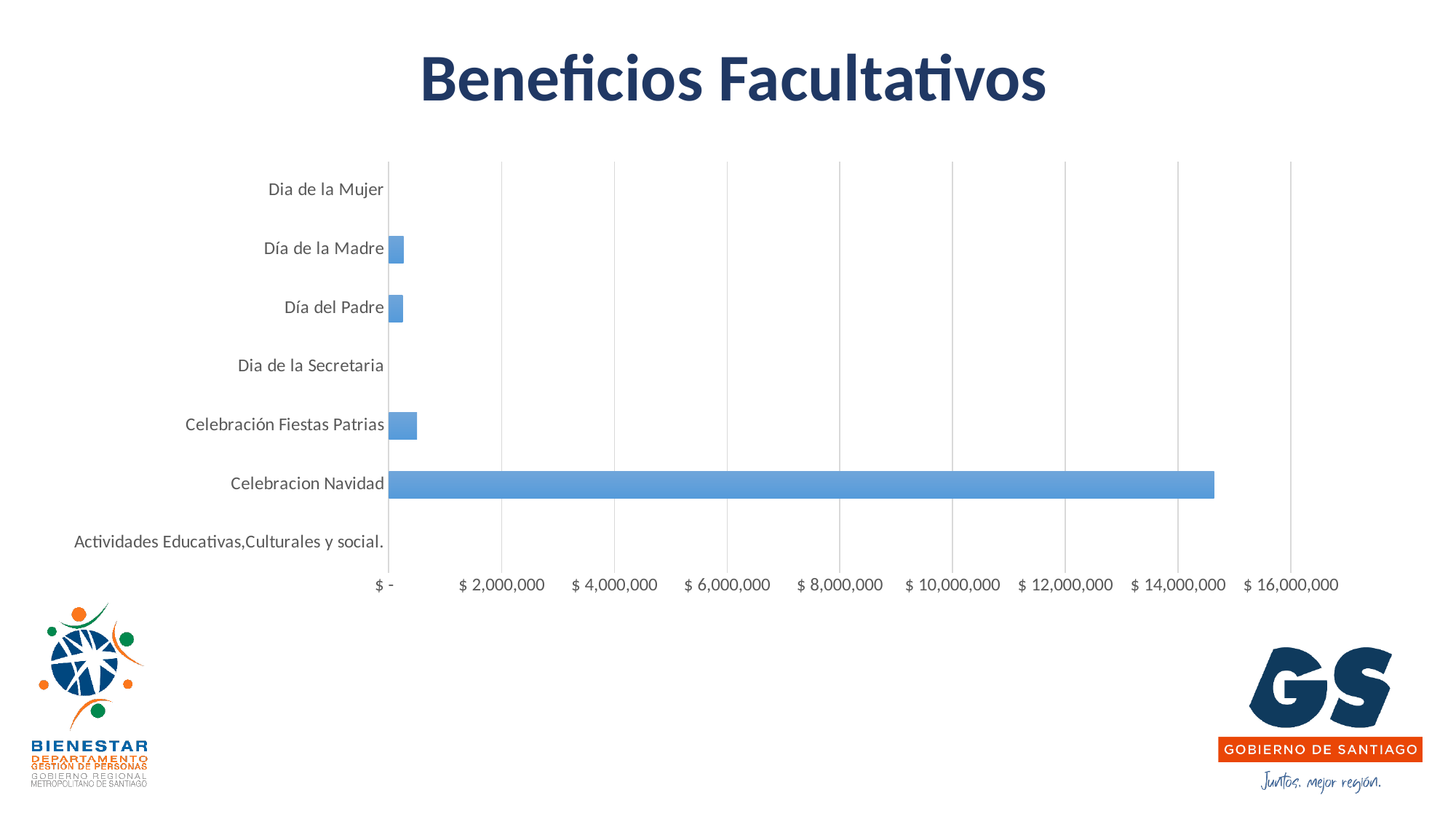
What is the title of the chart? Beneficios Facultativos Is the value for Celebracion Navidad greater or less than $ 16,000,000? less How many categories in the chart show no visible bar? 3 Which category has the highest value in the chart? Celebracion Navidad How many categories are listed on the vertical axis of the chart? 7 Is the value for Día del Padre greater or less than $ 2,000,000? less Which is larger, the value for Celebracion Navidad or the value for Celebración Fiestas Patrias? Celebracion Navidad What kind of chart is shown on the slide? bar chart Is the value for Celebración Fiestas Patrias greater or less than $ 2,000,000? less What is the highest tick label shown on the horizontal axis? $ 16,000,000 Which is larger, the value for Celebración Fiestas Patrias or the value for Día de la Madre? Celebración Fiestas Patrias